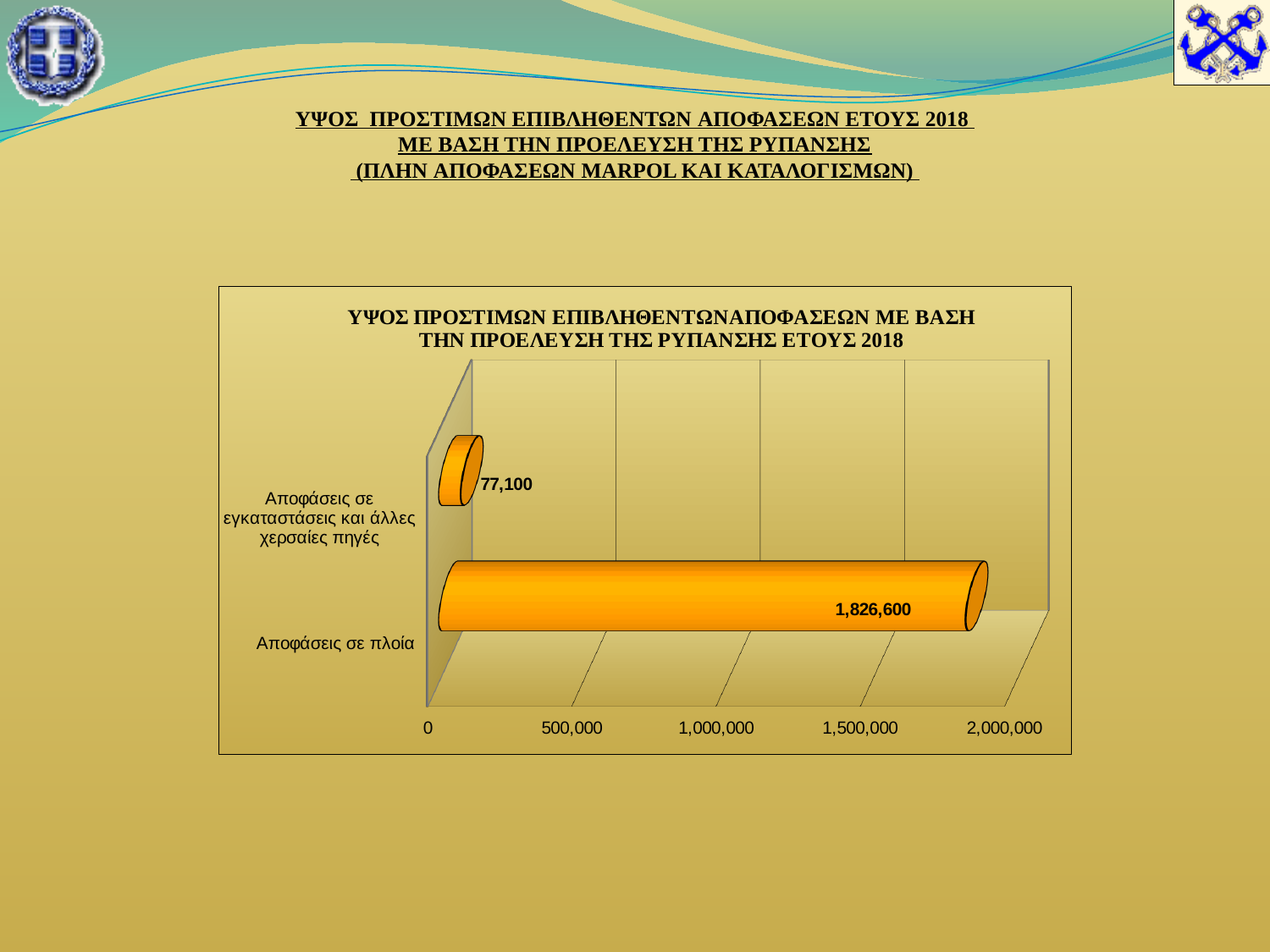
What is the difference between the value for Αποφάσεις σε πλοία and the value for Αποφάσεις σε εγκαταστάσεις και άλλες χερσαίες πηγές? 1,749,500 What is the highest value shown on the horizontal axis of the chart? 2,000,000 What is the total of the two values shown in the chart? 1,903,700 Which category has the lowest value? Αποφάσεις σε εγκαταστάσεις και άλλες χερσαίες πηγές Which category has the highest value? Αποφάσεις σε πλοία Which is larger: the value for Αποφάσεις σε πλοία or the value for Αποφάσεις σε εγκαταστάσεις και άλλες χερσαίες πηγές? Αποφάσεις σε πλοία What is the value for Αποφάσεις σε εγκαταστάσεις και άλλες χερσαίες πηγές? 77,100 What kind of chart is shown on the slide? bar chart Is the value for Αποφάσεις σε εγκαταστάσεις και άλλες χερσαίες πηγές greater or less than 500,000? less What is the value for Αποφάσεις σε πλοία? 1,826,600 Is the value for Αποφάσεις σε πλοία greater or less than 1,500,000? greater How many categories are shown in the chart? 2